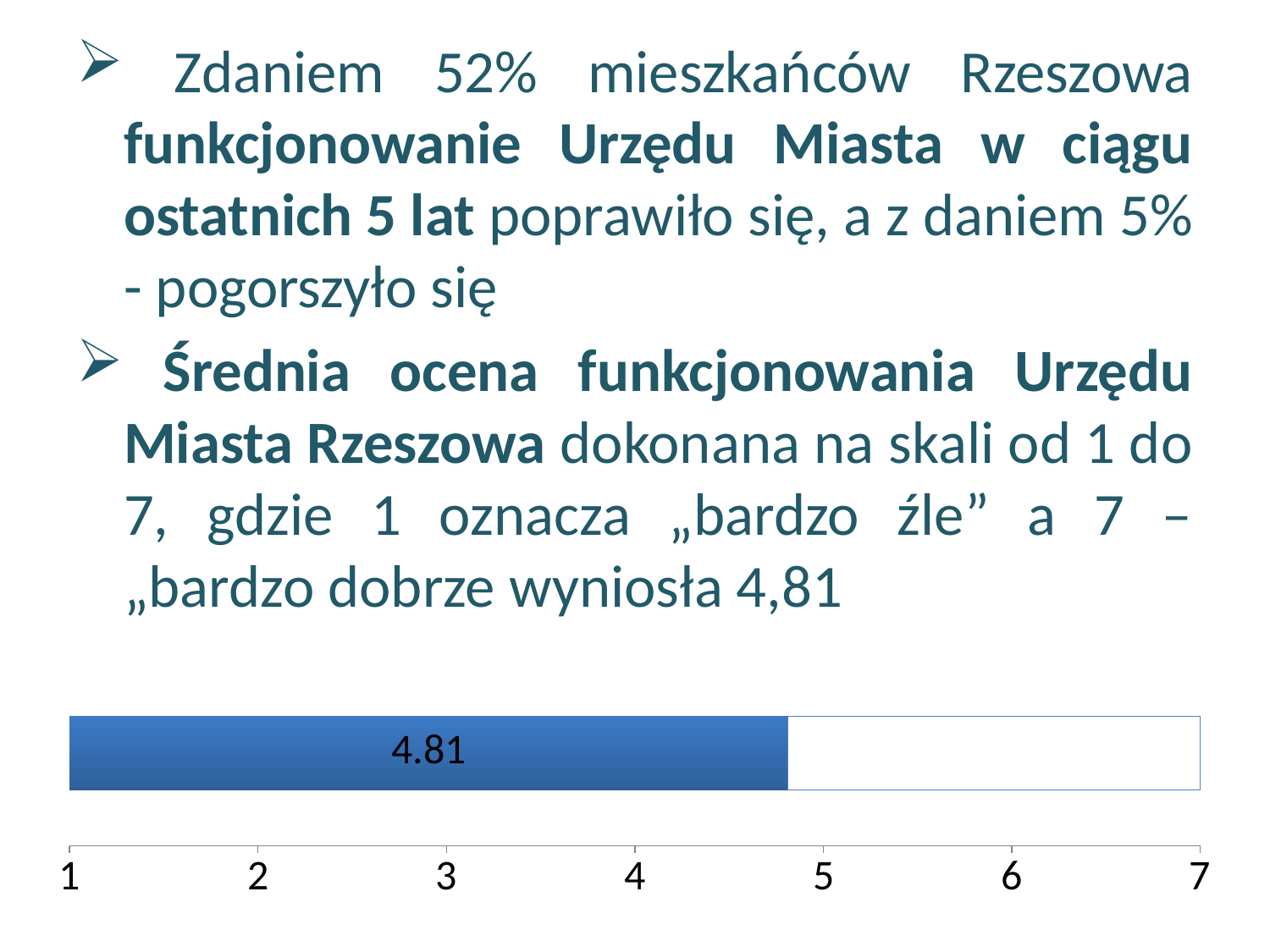
What is the lowest value shown on the chart's axis? 1 Is the value of the bar greater or less than 5? less What value is printed on the bar in the chart? 4.81 What is the highest value shown on the chart's axis? 7 What kind of chart is shown at the bottom of the slide? bar chart Is the value of the bar greater or less than 4? greater Is the bar in the chart oriented horizontally or vertically? horizontally